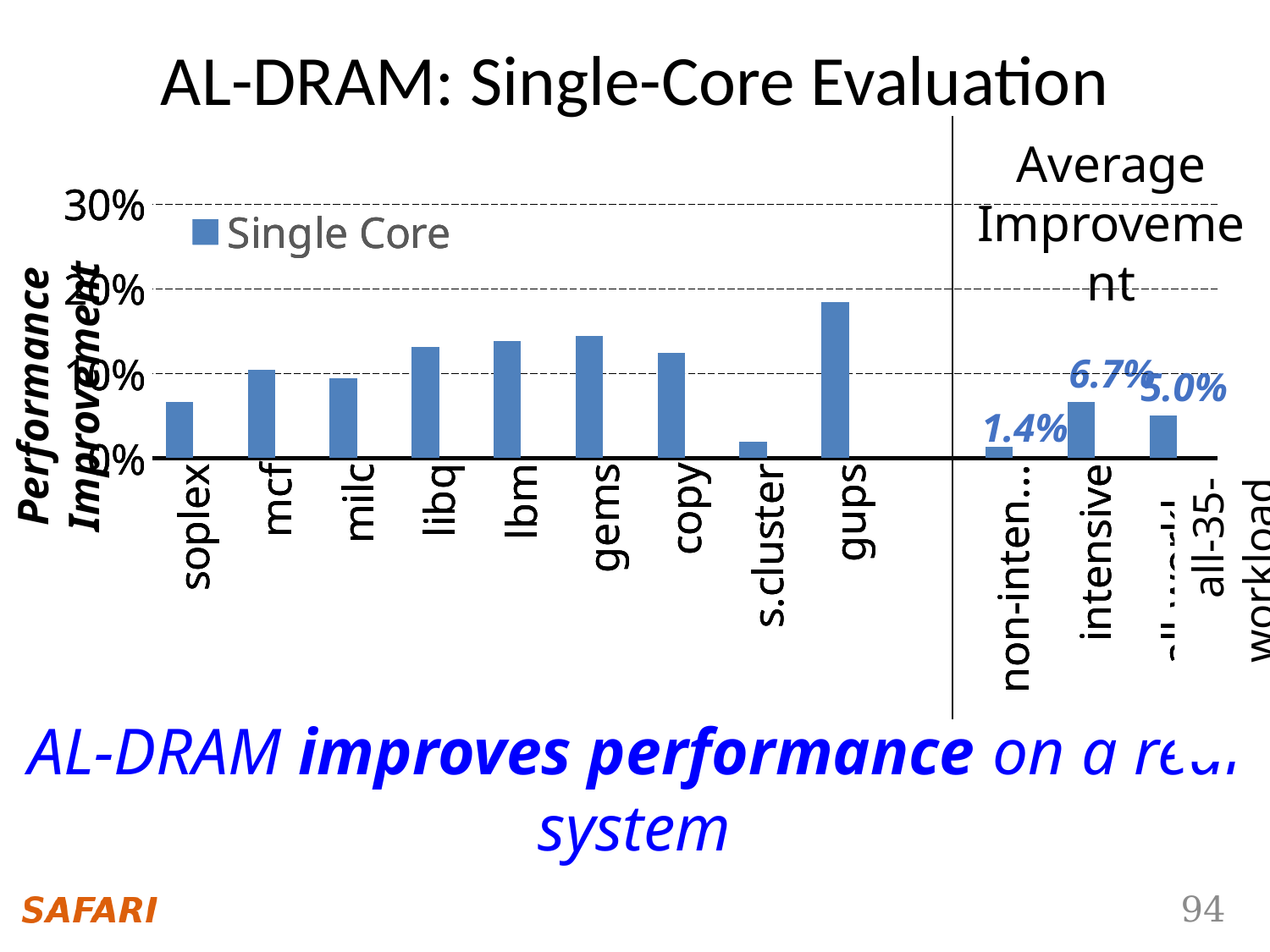
What is the average performance improvement shown for the non-intensive workloads? 1.4% Is the performance improvement for soplex greater or less than 10%? less What is the series name shown in the legend? Single Core What is the average performance improvement shown for all 35 workloads? 5.0% Which individual workload has the lowest performance improvement? s.cluster Is the performance improvement for gups greater or less than 10%? greater Which individual workload has the highest performance improvement? gups Which has a larger performance improvement, gups or s.cluster? gups What is the difference between the average improvement for intensive workloads and for non-intensive workloads? 5.3% What kind of chart is shown on the slide? bar chart What is the average performance improvement shown for the intensive workloads? 6.7% How many series does the legend list? 1